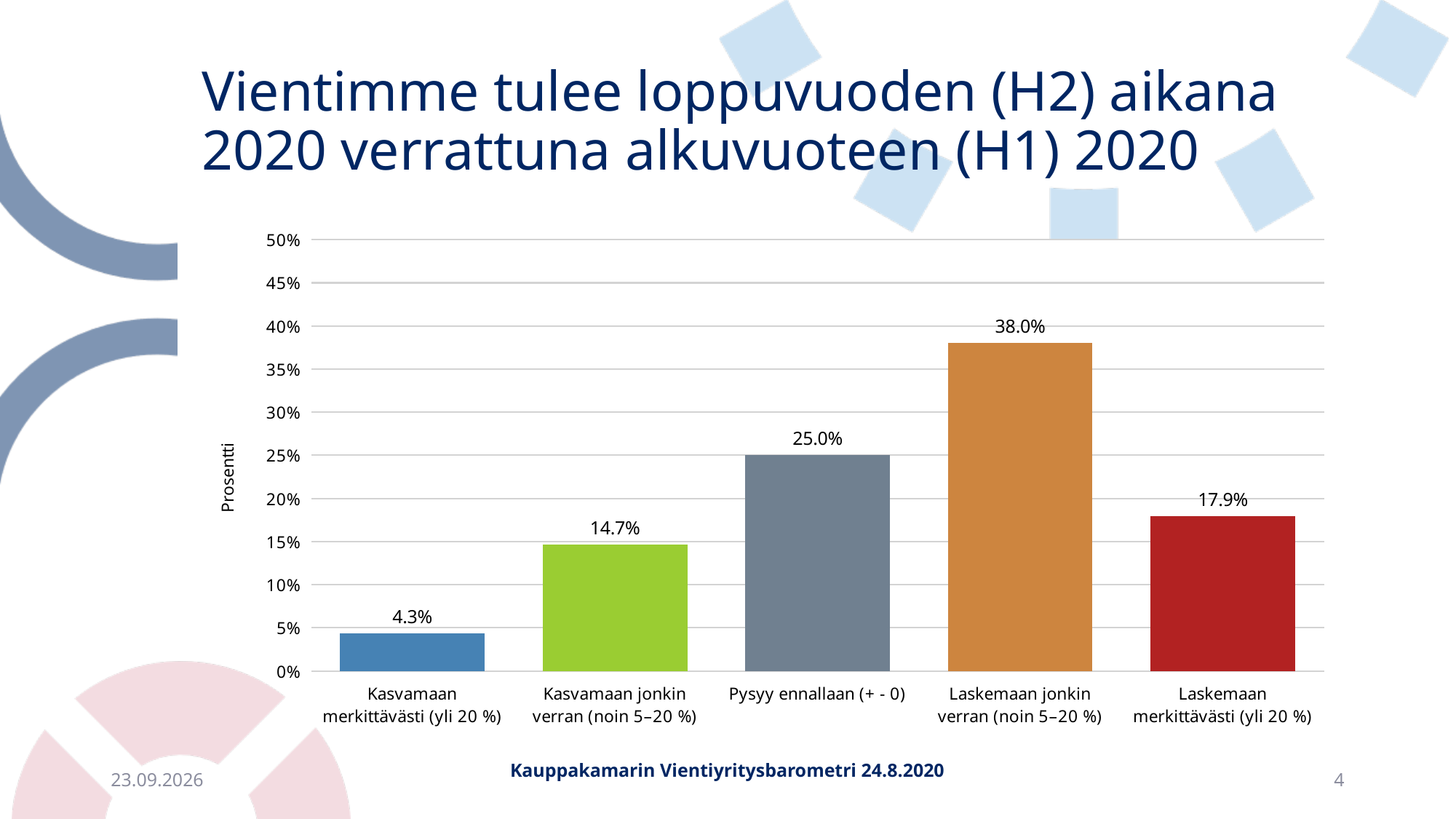
What kind of chart is shown on the slide? bar chart What is the value for "Laskemaan jonkin verran (noin 5–20 %)"? 38.0% Which category has the lowest value? Kasvamaan merkittävästi (yli 20 %) What is the difference between the values for "Laskemaan jonkin verran (noin 5–20 %)" and "Pysyy ennallaan (+ - 0)"? 13.0% Is the value for "Pysyy ennallaan (+ - 0)" greater or less than 30%? less Which is larger, the value for "Kasvamaan jonkin verran (noin 5–20 %)" or "Laskemaan merkittävästi (yli 20 %)"? Laskemaan merkittävästi (yli 20 %) How many categories are shown on the x axis? 5 What is the label of the vertical axis? Prosentti What is the difference between the values for "Laskemaan merkittävästi (yli 20 %)" and "Kasvamaan jonkin verran (noin 5–20 %)"? 3.2% What is the value for "Kasvamaan merkittävästi (yli 20 %)"? 4.3% Which category has the highest value? Laskemaan jonkin verran (noin 5–20 %) What is the value for "Pysyy ennallaan (+ - 0)"? 25.0%